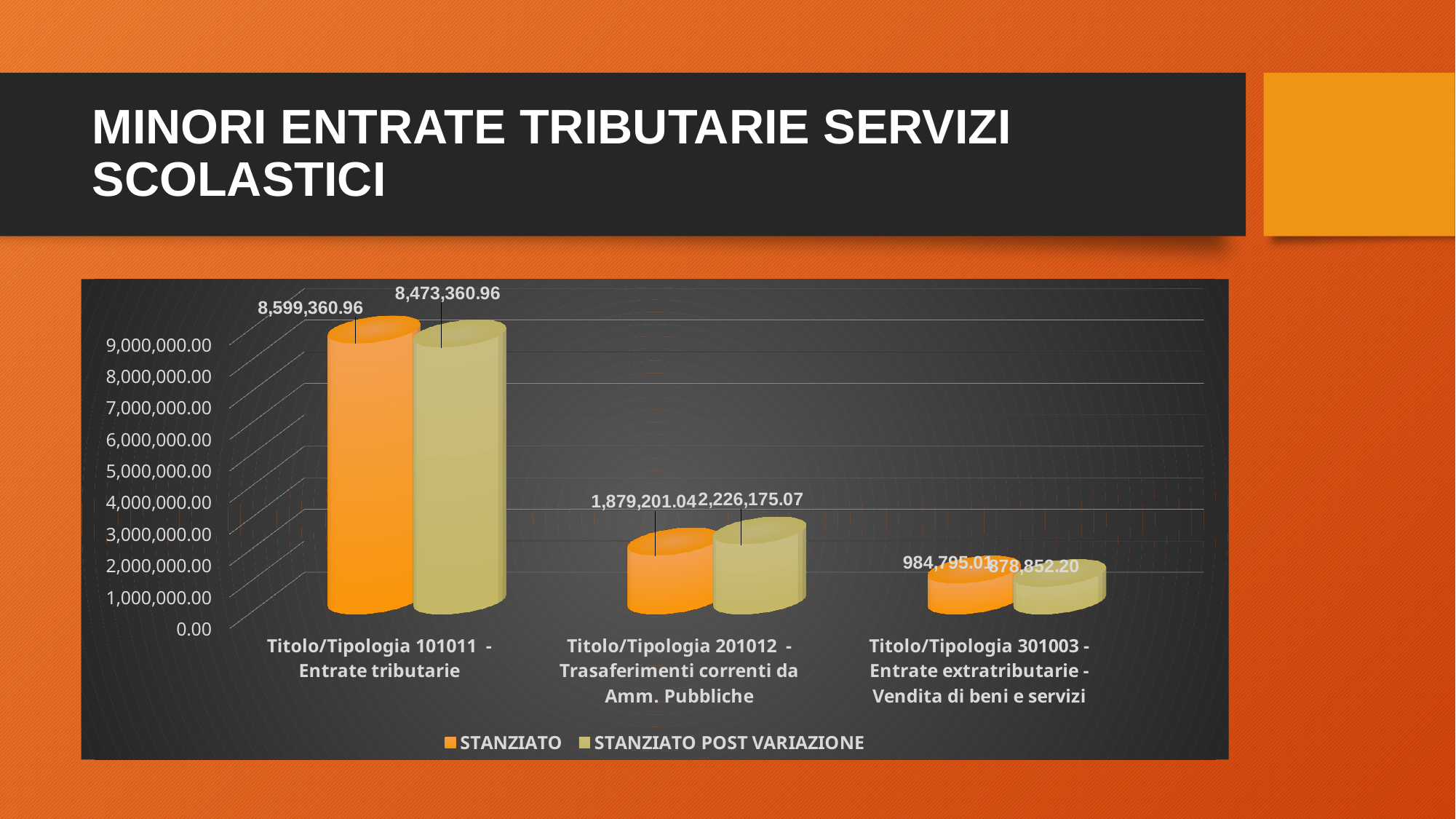
What type of chart is shown on the slide? Bar chart Which category has the lowest STANZIATO POST VARIAZIONE value? Titolo/Tipologia 301003 - Entrate extratributarie - Vendita di beni e servizi What is the STANZIATO value for Titolo/Tipologia 101011 - Entrate tributarie? 8,599,360.96 What is the difference between the STANZIATO and STANZIATO POST VARIAZIONE values for Titolo/Tipologia 101011 - Entrate tributarie? 126,000.00 What is the STANZIATO POST VARIAZIONE value for Titolo/Tipologia 301003 - Entrate extratributarie - Vendita di beni e servizi? 878,852.20 What is the STANZIATO POST VARIAZIONE value for Titolo/Tipologia 101011 - Entrate tributarie? 8,473,360.96 How many categories are shown on the x axis of the chart? 3 What is the difference between the STANZIATO POST VARIAZIONE and STANZIATO values for Titolo/Tipologia 201012 - Trasaferimenti correnti da Amm. Pubbliche? 346,974.03 What is the STANZIATO value for Titolo/Tipologia 201012 - Trasaferimenti correnti da Amm. Pubbliche? 1,879,201.04 For Titolo/Tipologia 301003 - Entrate extratributarie, which is larger: STANZIATO or STANZIATO POST VARIAZIONE? STANZIATO Which category has the highest STANZIATO value? Titolo/Tipologia 101011 - Entrate tributarie How many series does the chart legend list? 2